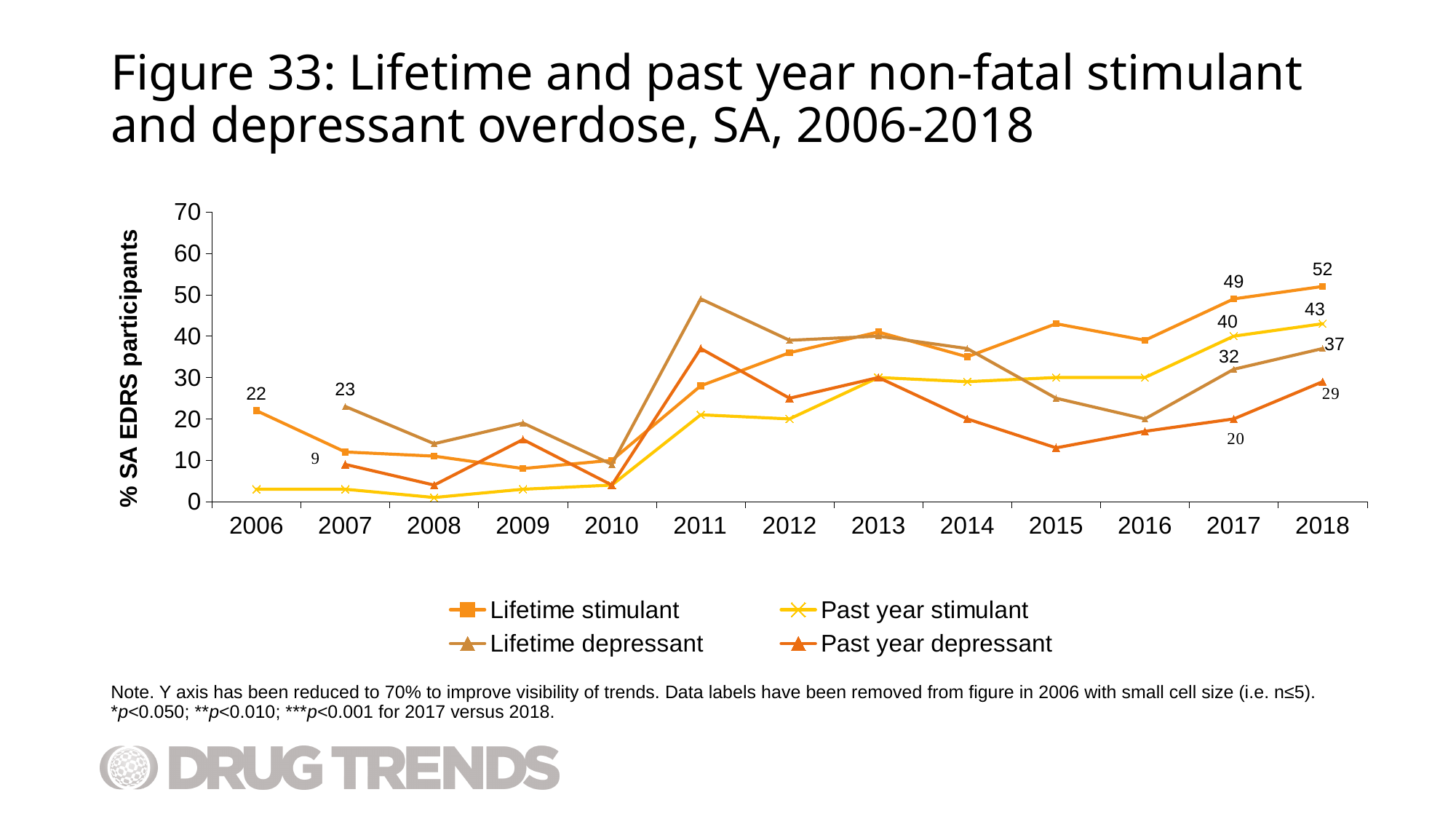
What is the value for Past year depressant in 2018? 29 What is the value for Lifetime depressant in 2007? 23 What is the difference between Lifetime stimulant and Past year depressant in 2018? 23 Which series has the highest value in 2018? Lifetime stimulant What is the value for Past year stimulant in 2017? 40 How many years are shown on the x axis? 13 Is the value for Lifetime depressant in 2011 greater or less than 40? greater What is the value for Lifetime stimulant in 2018? 52 How many series does the legend list? 4 What kind of chart is shown on the slide? line chart Which series has the lowest value in 2018? Past year depressant By how much did Lifetime stimulant increase from 2017 to 2018? 3